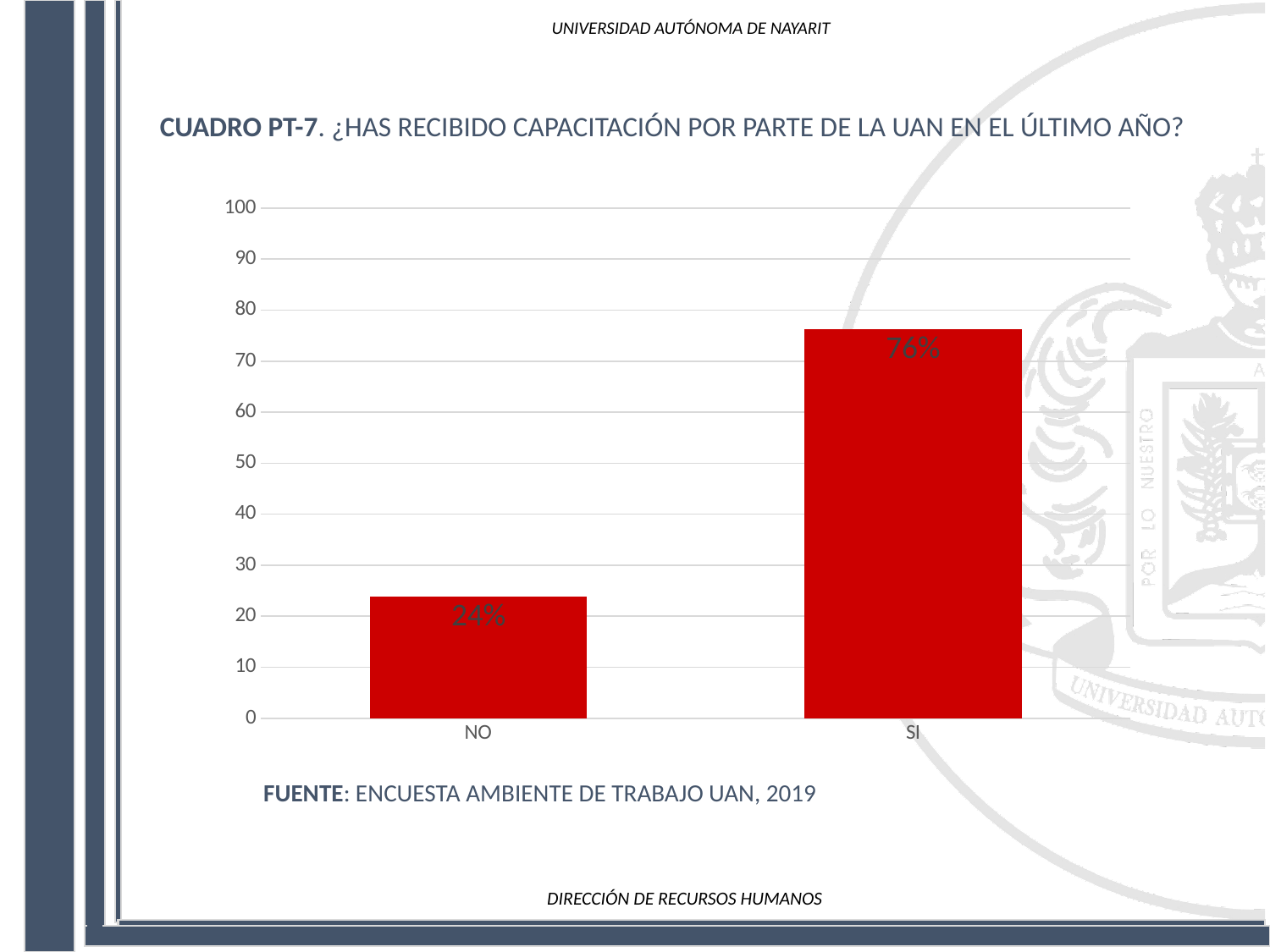
Which is larger, the value for NO or the value for SI? SI What is the value for NO? 24% What is the difference between the values for SI and NO? 52% What colour are the bars in the chart? red What is the source cited below the chart? ENCUESTA AMBIENTE DE TRABAJO UAN, 2019 What kind of chart is shown on the slide? bar chart Which category has the lowest value? NO Which category has the highest value? SI Is the value for SI greater or less than 70? greater Is the value for NO greater or less than 30? less What is the value for SI? 76% How many categories are shown on the x axis? 2